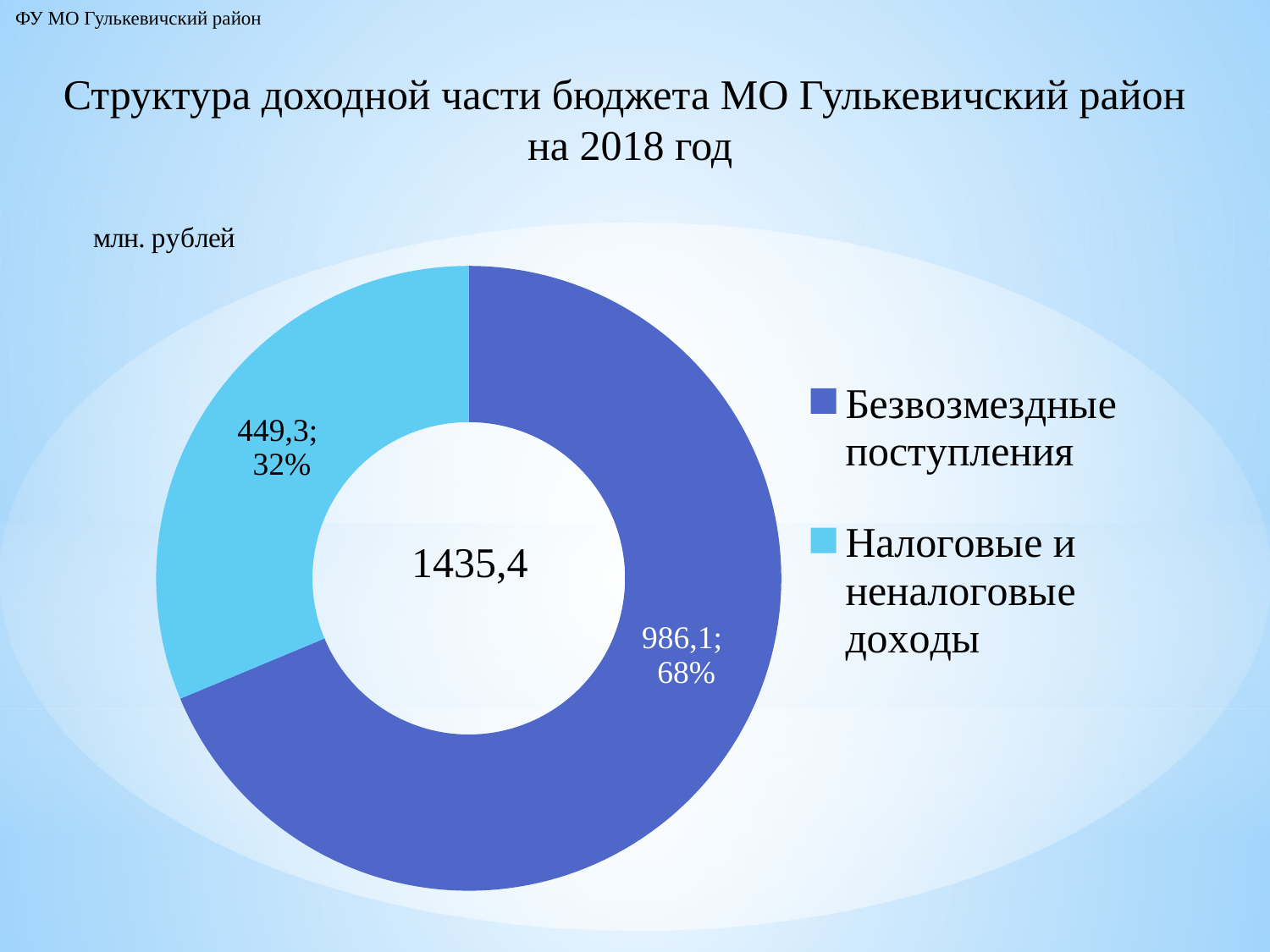
What kind of chart is shown on the slide? Pie chart (doughnut) Which category is the largest? Безвозмездные поступления Which category is the smallest? Налоговые и неналоговые доходы What is the difference between Безвозмездные поступления and Налоговые и неналоговые доходы? 536,8 What share of the pie does Налоговые и неналоговые доходы take? 32% What unit is indicated for the chart values? млн. рублей What is the value for Безвозмездные поступления? 986,1 What share of the pie does Безвозмездные поступления take? 68% How many categories does the chart show? 2 What total value is shown in the centre of the chart? 1435,4 What is the value for Налоговые и неналоговые доходы? 449,3 Which is larger, Безвозмездные поступления or Налоговые и неналоговые доходы? Безвозмездные поступления